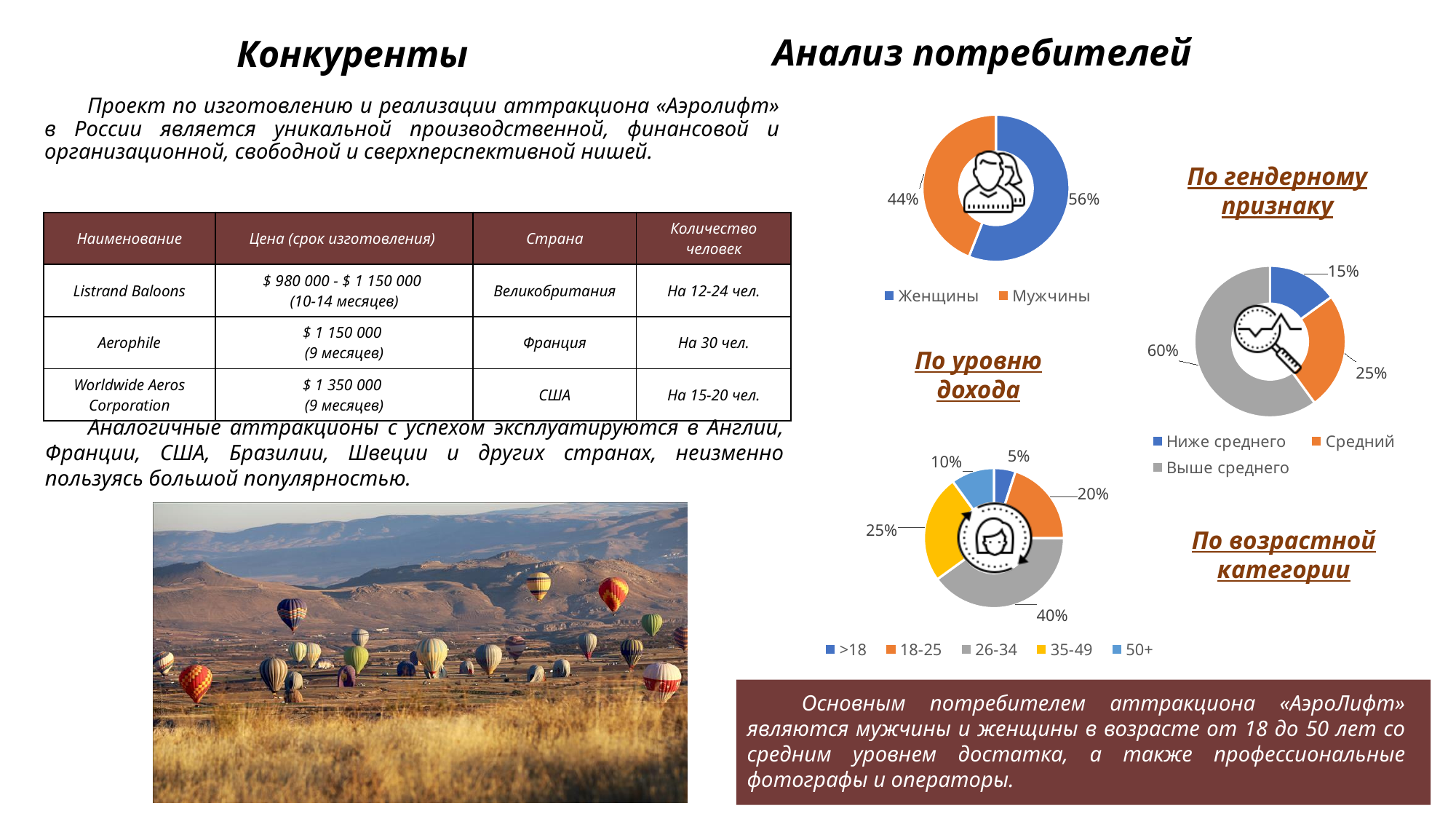
In the age chart (По возрастной категории), what share is the 26-34 group? 40% In the gender chart (По гендерному признаку), which group has the larger share, Женщины or Мужчины? Женщины In the income chart (По уровню дохода), what share is Выше среднего? 60% What type of chart is used for the age chart (По возрастной категории)? Doughnut chart In the income chart (По уровню дохода), which category has the smallest share? Ниже среднего In the age chart (По возрастной категории), what is the difference between the 35-49 and 50+ shares? 15% In the gender chart (По гендерному признаку), what share is Мужчины? 44% In the income chart (По уровню дохода), what share is Ниже среднего? 15% In the gender chart (По гендерному признаку), what share is Женщины? 56% In the age chart (По возрастной категории), which age group has the largest share? 26-34 In the gender chart (По гендерному признаку), what is the difference between the Женщины and Мужчины shares? 12% In the income chart (По уровню дохода), how many categories does the legend list? 3